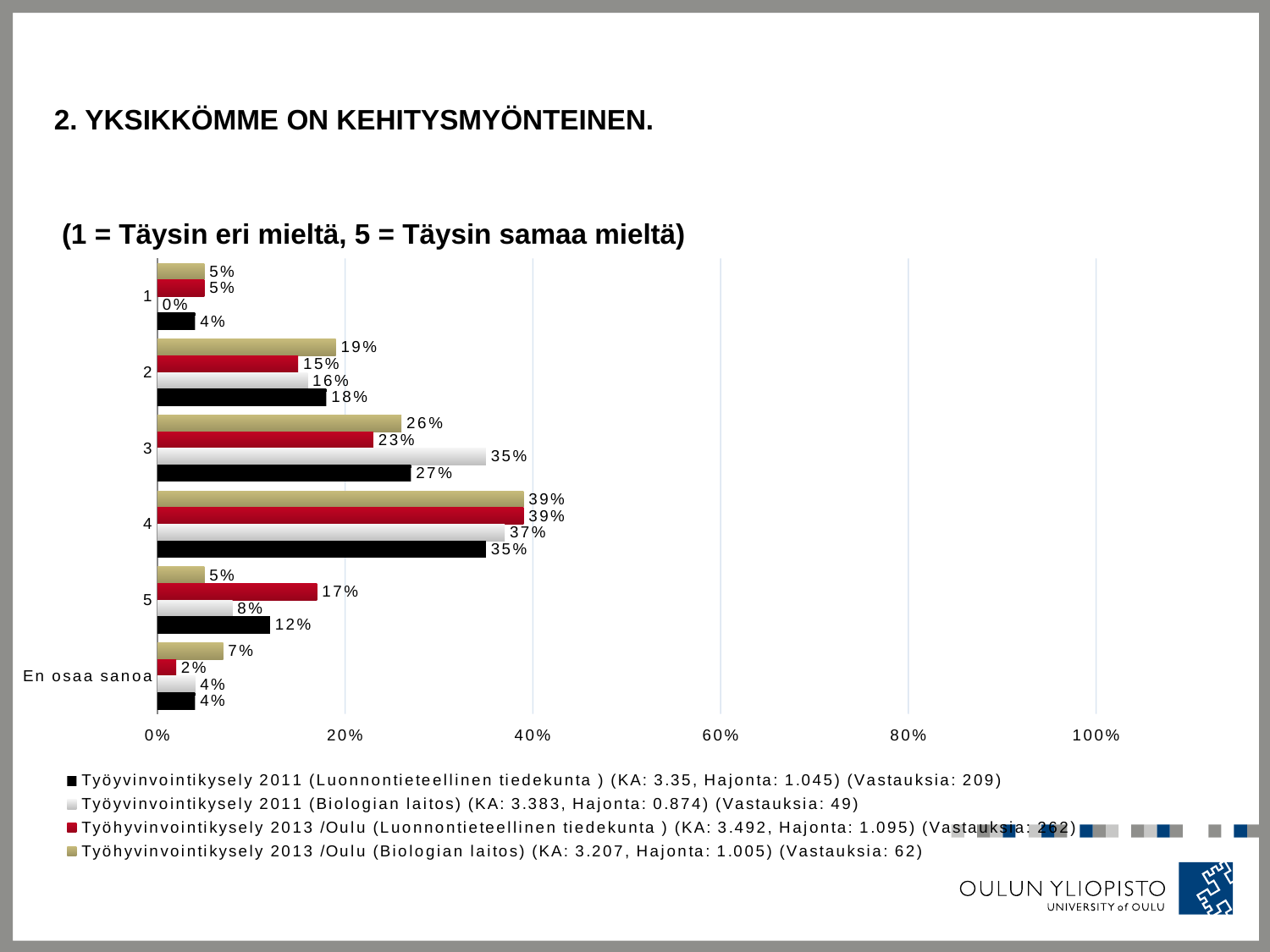
Which category has the lowest value in the Työyvinvointikysely 2011 (Biologian laitos) series? 1 What is the difference between the Työyvinvointikysely 2011 (Biologian laitos) value and the Työhyvinvointikysely 2013 /Oulu (Luonnontieteellinen tiedekunta) value for category 3? 12% Is the value for category 4 in the Työhyvinvointikysely 2013 /Oulu (Luonnontieteellinen tiedekunta) series greater or less than 20%? greater What is the value for category 4 in the Työyvinvointikysely 2011 (Luonnontieteellinen tiedekunta) series? 35% How many categories are shown on the vertical axis of the chart? 6 What is the value for category 3 in the Työyvinvointikysely 2011 (Biologian laitos) series? 35% For category 5, which series has the larger value: Työhyvinvointikysely 2013 /Oulu (Luonnontieteellinen tiedekunta) or Työyvinvointikysely 2011 (Luonnontieteellinen tiedekunta)? Työhyvinvointikysely 2013 /Oulu (Luonnontieteellinen tiedekunta) How many series does the legend list? 4 Which category has the highest value in the Työhyvinvointikysely 2013 /Oulu (Biologian laitos) series? 4 What kind of chart is shown on the slide? Bar chart What is the value for category 5 in the Työhyvinvointikysely 2013 /Oulu (Luonnontieteellinen tiedekunta) series? 17% What is the value for 'En osaa sanoa' in the Työhyvinvointikysely 2013 /Oulu (Biologian laitos) series? 7%